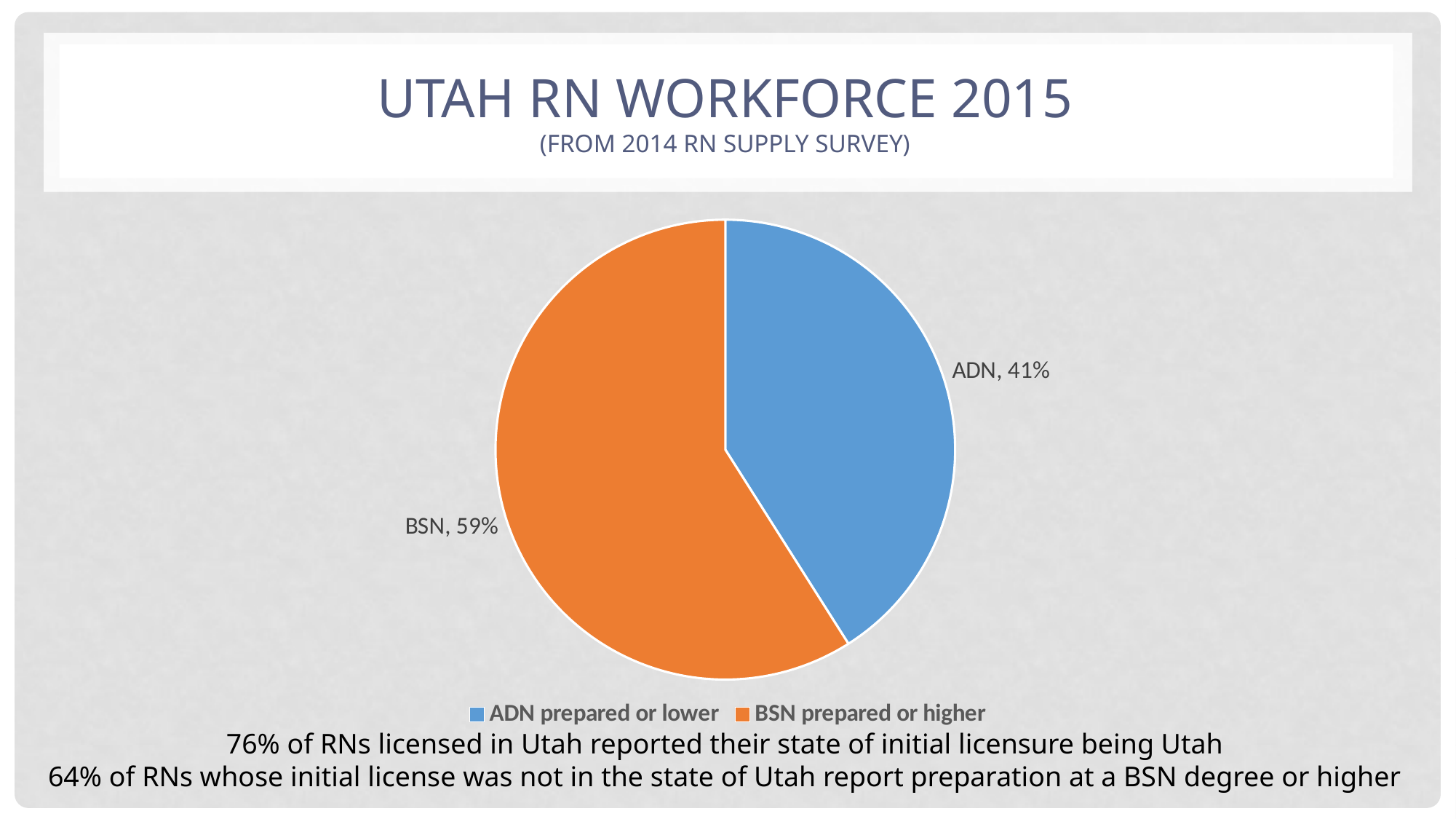
What is the difference in percentage points between the BSN slice and the ADN slice? 18 How many entries does the legend list? 2 What is the full legend label for the orange slice? BSN prepared or higher What kind of chart is shown on the slide? pie chart What percentage of the pie is labelled ADN? 41% What share of the pie does the BSN slice represent? 59% Which is larger, the ADN slice or the BSN slice? BSN How many slices does the pie chart have? 2 Which slice of the pie is the largest? BSN What percentage of the pie is labelled BSN? 59% Which slice of the pie is the smallest? ADN What colour is the slice for ADN prepared or lower? blue